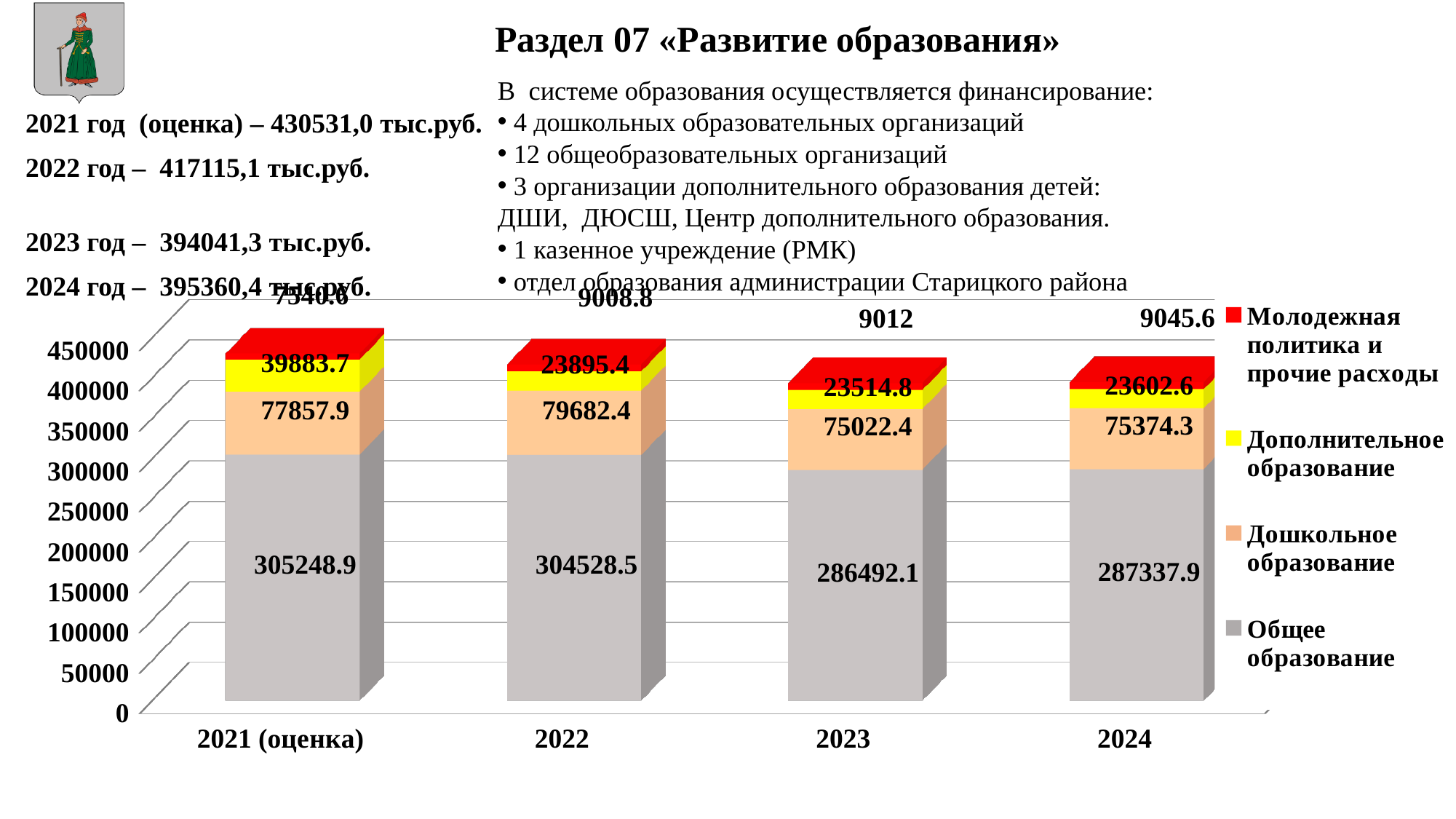
By how much does Дополнительное образование in 2021 (оценка) exceed Дополнительное образование in 2022? 15988.3 What is the total of the stacked bar for 2022? 417115.1 What kind of chart is shown on the slide? Stacked bar chart What is the value of Общее образование for 2022? 304528.5 What is the value of Дошкольное образование for 2023? 75022.4 In which year is the value of Общее образование the highest? 2021 (оценка) What is the value of Молодежная политика и прочие расходы for 2024? 9045.6 What is the value of Дополнительное образование for 2021 (оценка)? 39883.7 How many series does the chart legend list? 4 In which year is the value of Дошкольное образование the lowest? 2023 Which year has the larger value for Молодежная политика и прочие расходы, 2023 or 2024? 2024 How many years (categories) are shown on the x axis of the chart? 4